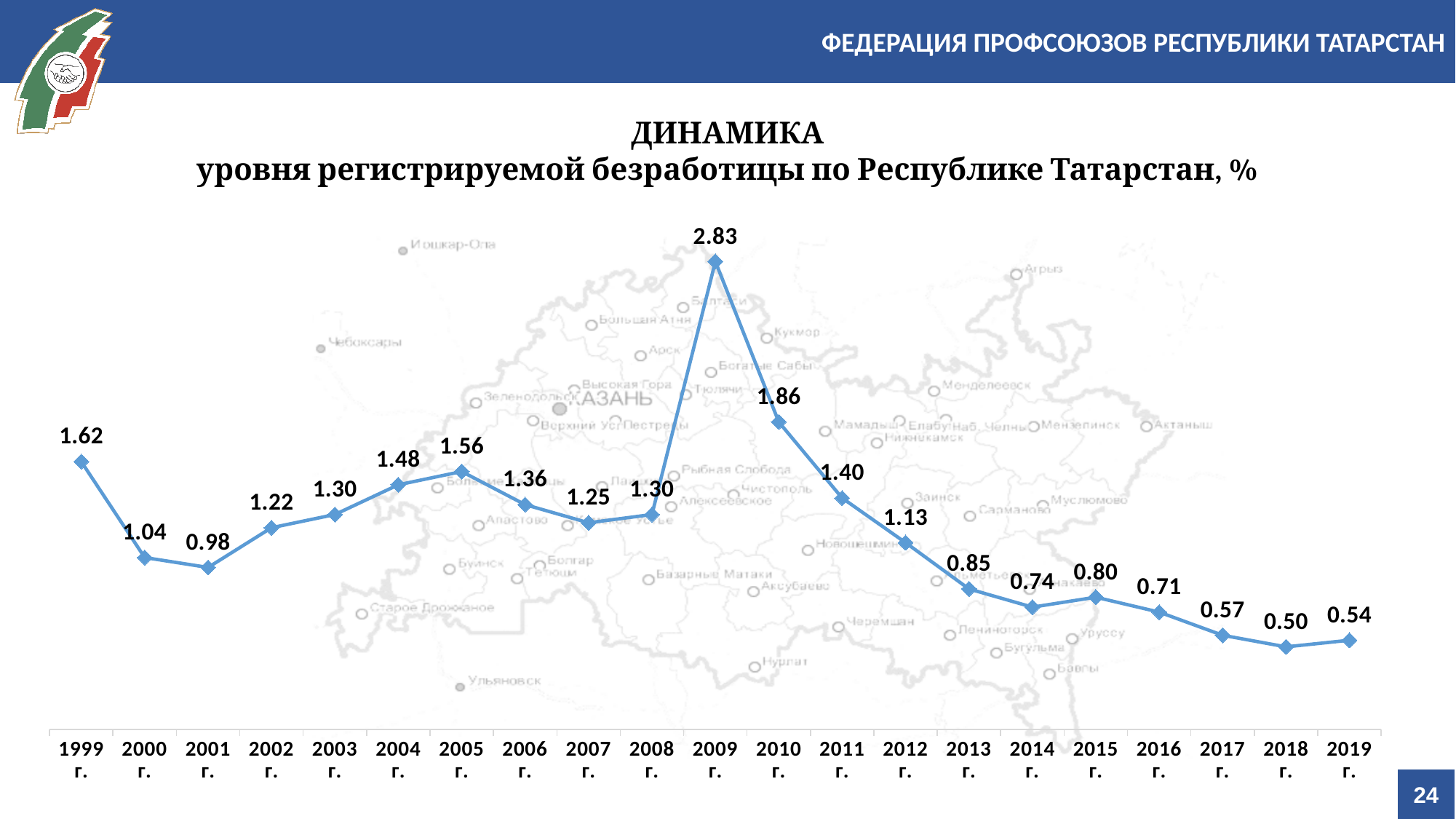
Which year has the larger value, 2005 or 2006? 2005 What is the difference between the values for 2009 and 2010? 0.97 Which year has the highest registered unemployment rate on the chart? 2009 What value is shown for 1999? 1.62 Which year has the lowest value on the chart? 2018 Which year has the larger value, 2014 or 2015? 2015 What kind of chart is shown on the slide? Line chart What is the registered unemployment rate shown for 2009? 2.83 What is the value plotted for 2019? 0.54 What is the difference between the values for 1999 and 2019? 1.08 How many years (data points) are plotted on the chart? 21 Do the values rise or fall from 2010 to 2014? Fall